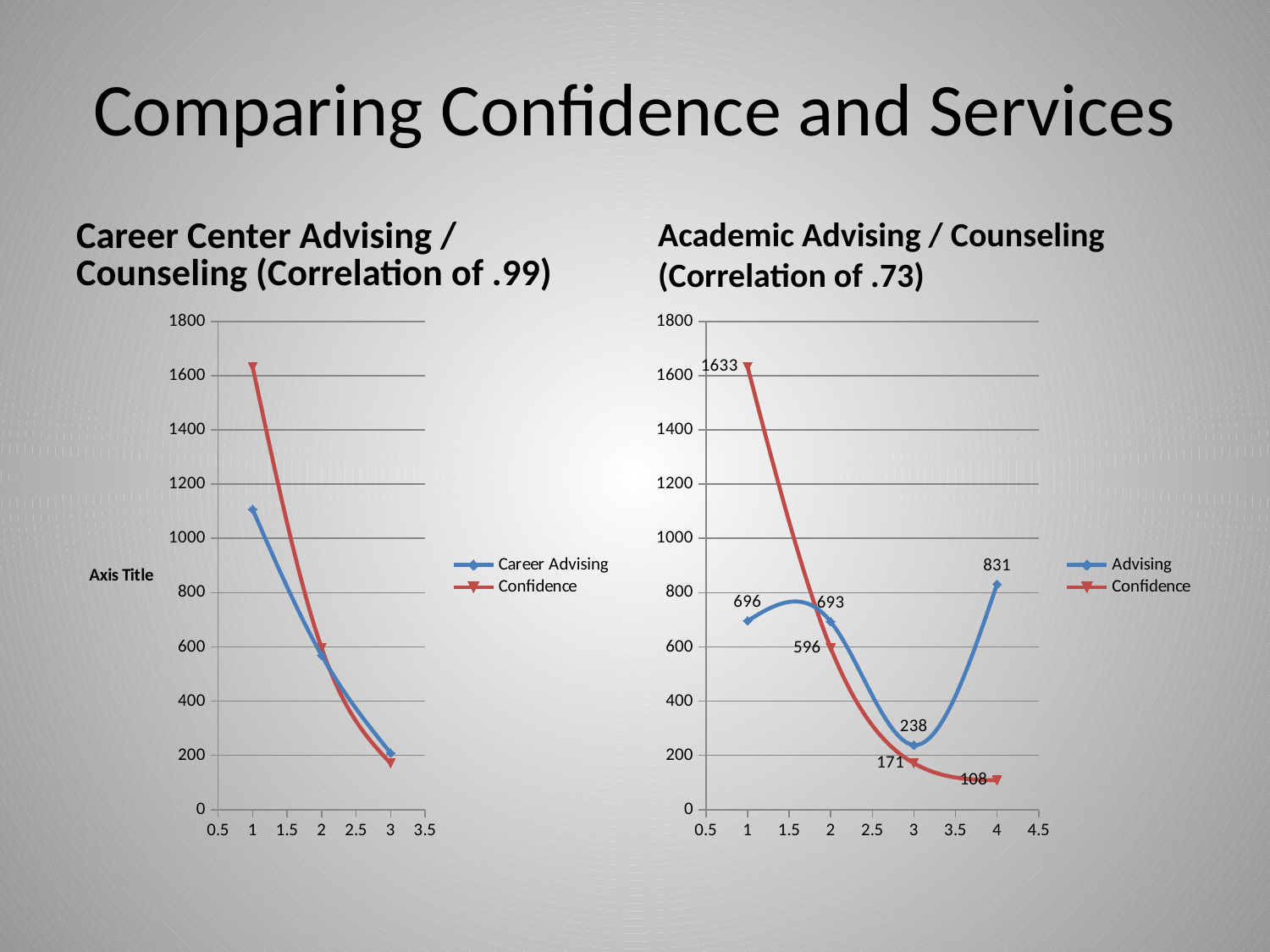
In the Academic Advising / Counseling chart, what is the Confidence value at x = 1? 1633 In the Academic Advising / Counseling chart, what is the difference between the Confidence values at x = 1 and x = 2? 1037 In the Academic Advising / Counseling chart, what is the Advising value at x = 3? 238 In the Academic Advising / Counseling chart, at x = 2, which series has the larger value, Advising or Confidence? Advising In the Academic Advising / Counseling chart, what is the Advising value at x = 4? 831 What type of chart is the Career Center Advising / Counseling chart? line chart In the Career Center Advising / Counseling chart, is the Career Advising value at x = 1 greater or less than 1000? greater In the Academic Advising / Counseling chart, what is the lowest Confidence value shown? 108 In the Academic Advising / Counseling chart, what is the highest Advising value shown? 831 In the Career Center Advising / Counseling chart, does the Confidence series rise or fall as x increases? fall How many data points does each series have in the Academic Advising / Counseling chart? 4 How many series does the legend of the Career Center Advising / Counseling chart list? 2